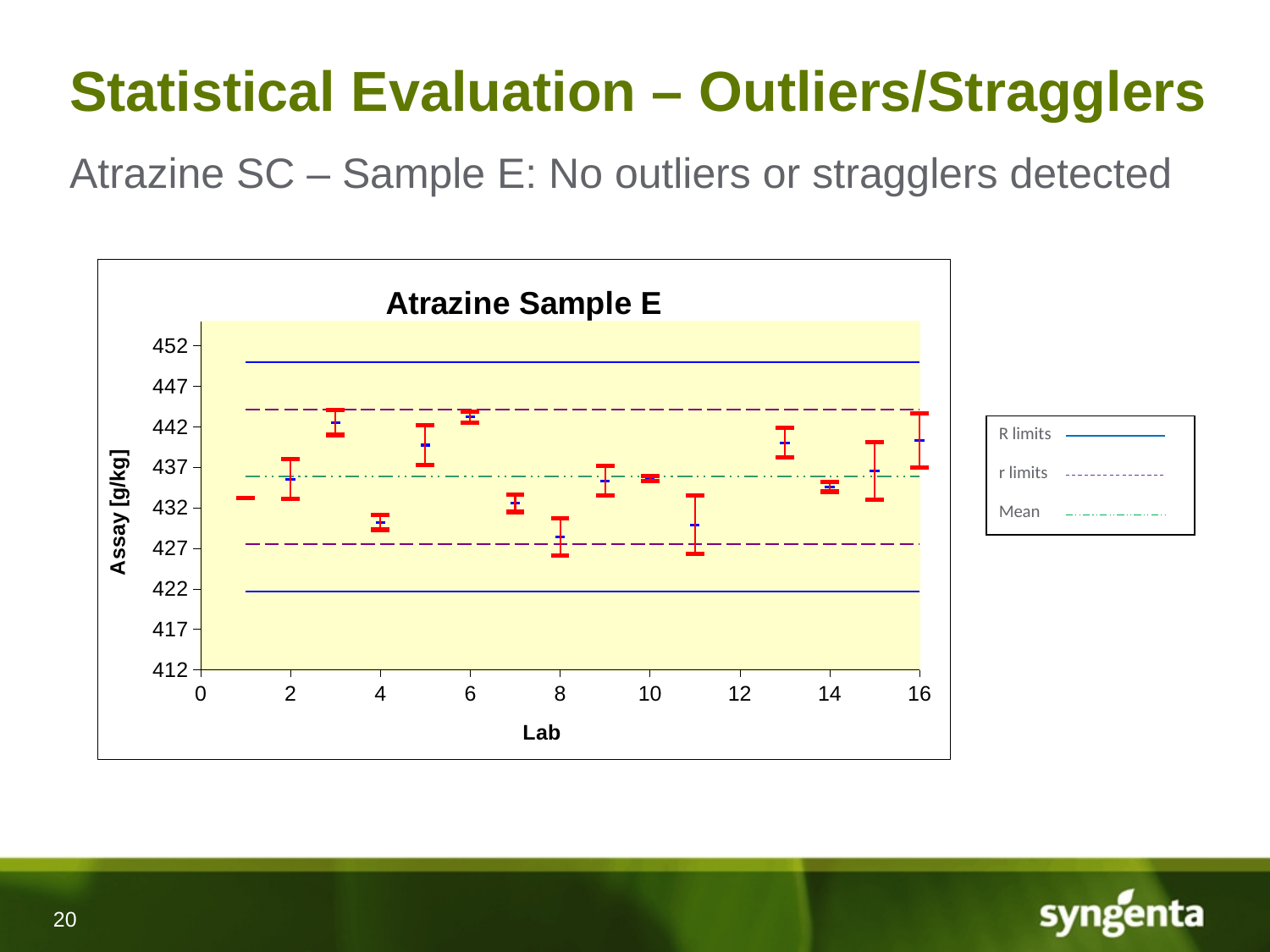
What is the title of the chart? Atrazine Sample E Is the value for Lab 8 greater or less than 432? less Is the value for Lab 11 greater or less than 432? less Which has the larger value, Lab 4 or Lab 5? Lab 5 How many labs are plotted on the chart? 15 How many entries does the chart legend list? 3 Is the value for Lab 4 greater or less than 432? less Which lab has the lowest plotted value? Lab 8 Which has the larger value, Lab 8 or Lab 13? Lab 13 What label is on the y axis of the chart? Assay [g/kg]